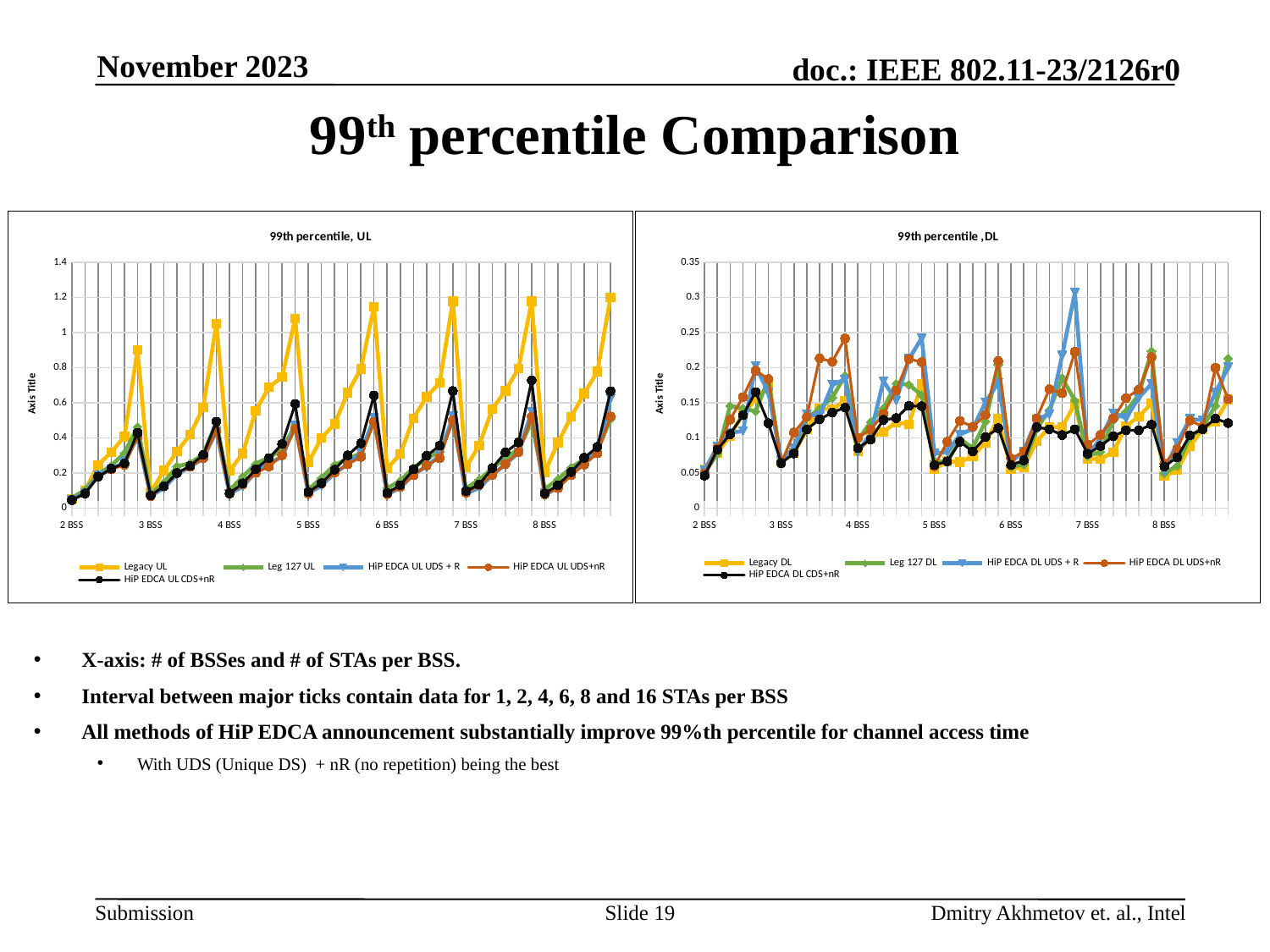
What kind of chart is the "99th percentile, UL" chart? line chart What is the maximum value shown on the y axis of the "99th percentile ,DL" chart? 0.35 How many series does the legend of the "99th percentile, UL" chart list? 5 In the "99th percentile, UL" chart, is the highest Legacy UL peak in the 8 BSS interval greater or less than 1? greater In the "99th percentile, UL" chart, which series reaches the highest values? Legacy UL How many BSS categories are labelled on the x axis of the "99th percentile, UL" chart? 7 In the "99th percentile ,DL" chart, which series reaches the single highest point? HiP EDCA DL UDS + R In the "99th percentile ,DL" chart, is the highest peak of HiP EDCA DL UDS + R greater or less than 0.25? greater What is the title of the left chart on the slide? 99th percentile, UL How many series does the legend of the "99th percentile ,DL" chart list? 5 What kind of chart is the "99th percentile ,DL" chart? line chart